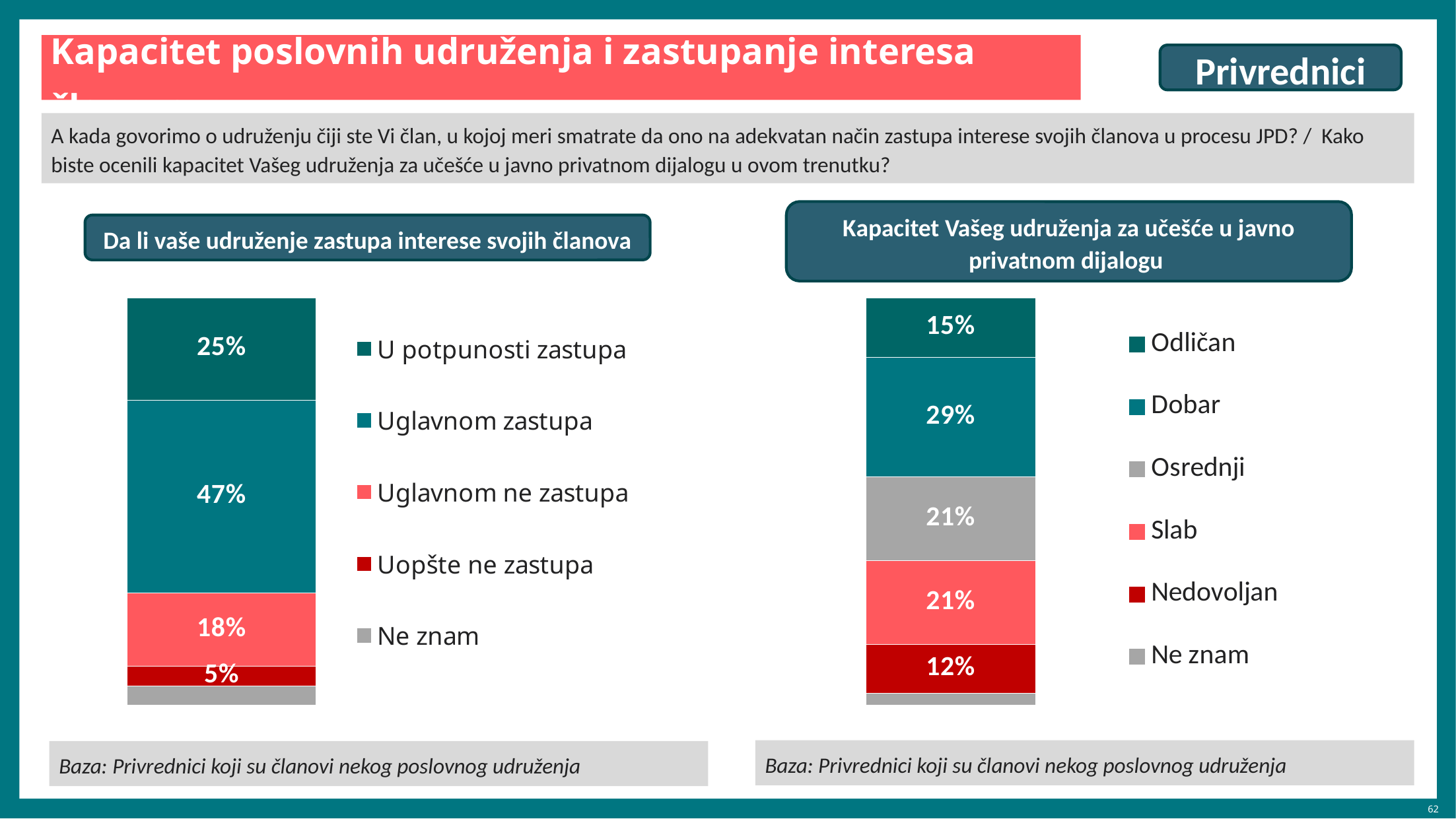
In the right chart 'Kapacitet Vašeg udruženja za učešće u javno privatnom dijalogu', which is larger, 'Dobar' or 'Osrednji'? Dobar In the right chart 'Kapacitet Vašeg udruženja za učešće u javno privatnom dijalogu', how many entries does the legend list? 6 In the left chart 'Da li vaše udruženje zastupa interese svojih članova', how many entries does the legend list? 5 In the right chart 'Kapacitet Vašeg udruženja za učešće u javno privatnom dijalogu', what is the difference between 'Dobar' and 'Nedovoljan'? 17% In the right chart 'Kapacitet Vašeg udruženja za učešće u javno privatnom dijalogu', what is the value for 'Nedovoljan'? 12% In the left chart 'Da li vaše udruženje zastupa interese svojih članova', which category has the highest value? Uglavnom zastupa In the right chart 'Kapacitet Vašeg udruženja za učešće u javno privatnom dijalogu', what is the value for 'Odličan'? 15% In the left chart 'Da li vaše udruženje zastupa interese svojih članova', what is the value for 'Uglavnom zastupa'? 47% In the right chart 'Kapacitet Vašeg udruženja za učešće u javno privatnom dijalogu', which category has the highest value? Dobar In the left chart 'Da li vaše udruženje zastupa interese svojih članova', what is the value for 'Uopšte ne zastupa'? 5% What type of chart is the right chart 'Kapacitet Vašeg udruženja za učešće u javno privatnom dijalogu'? Stacked bar chart In the left chart 'Da li vaše udruženje zastupa interese svojih članova', what is the difference between 'U potpunosti zastupa' and 'Uglavnom ne zastupa'? 7%